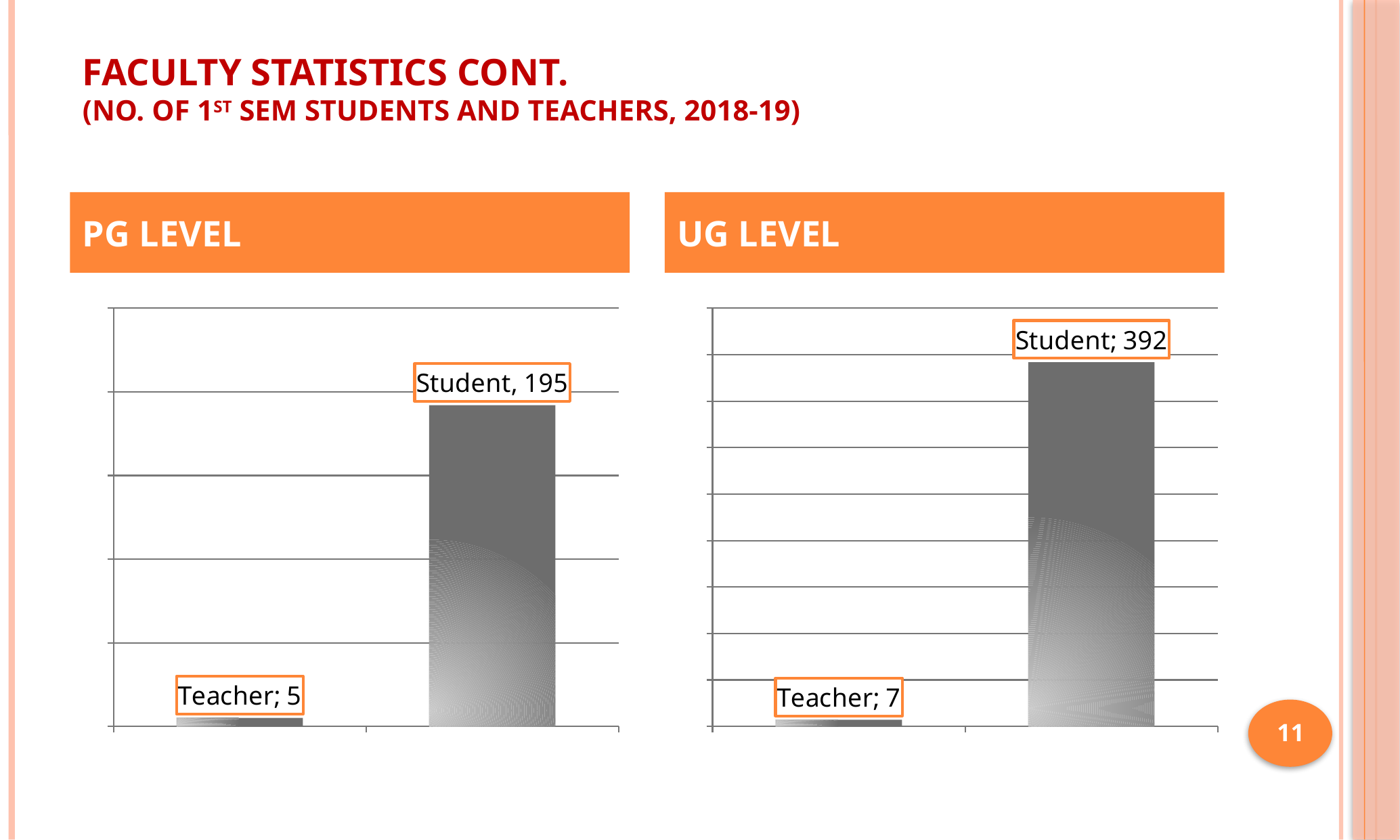
What is the title of the chart on the right side of the slide? UG LEVEL In the PG LEVEL chart, what is the value for Teacher? 5 Is the Student value in the UG LEVEL chart larger or smaller than the Student value in the PG LEVEL chart? larger In the PG LEVEL chart, which category has the highest value? Student In the UG LEVEL chart, what is the value for Student? 392 How many categories are shown in the PG LEVEL chart? 2 In the PG LEVEL chart, what is the difference between the Student and Teacher values? 190 In the UG LEVEL chart, what is the value for Teacher? 7 In the UG LEVEL chart, which category has the lowest value? Teacher In the PG LEVEL chart, what is the value for Student? 195 What kind of chart is the UG LEVEL chart? bar chart In the UG LEVEL chart, what is the difference between the Student and Teacher values? 385